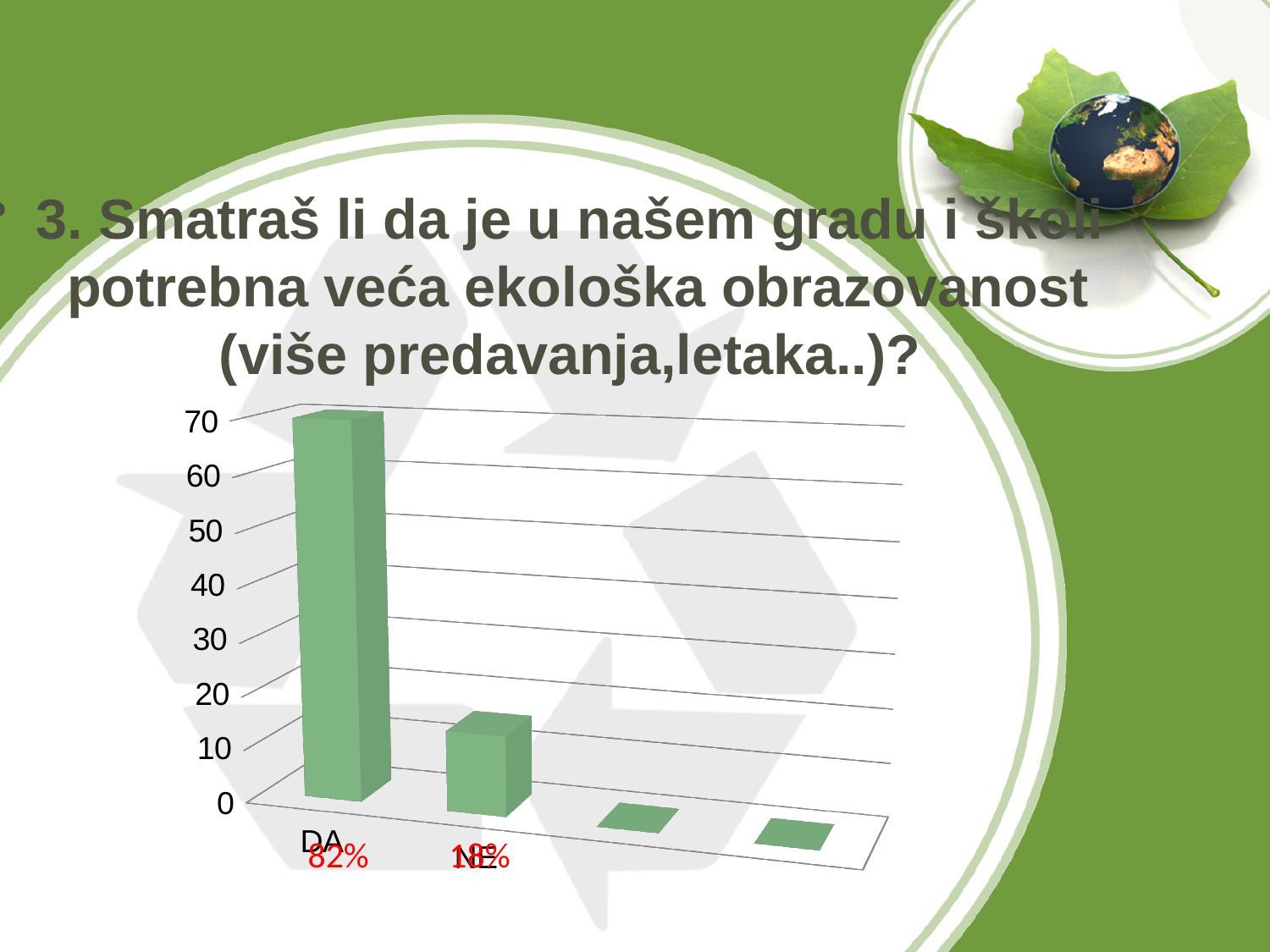
What kind of chart is shown on the slide? bar chart What percentage is printed in red under the DA bar? 82% What is the highest value shown on the vertical axis? 70 Which of the two labeled categories, DA or NE, has the lower bar? NE Which category has the highest bar? DA Is the value for NE greater or less than 30? less Is the value for DA greater or less than 50? greater Is the value for DA greater or less than 40? greater Which bar is taller, DA or NE? DA What percentage is printed in red under the NE bar? 18%